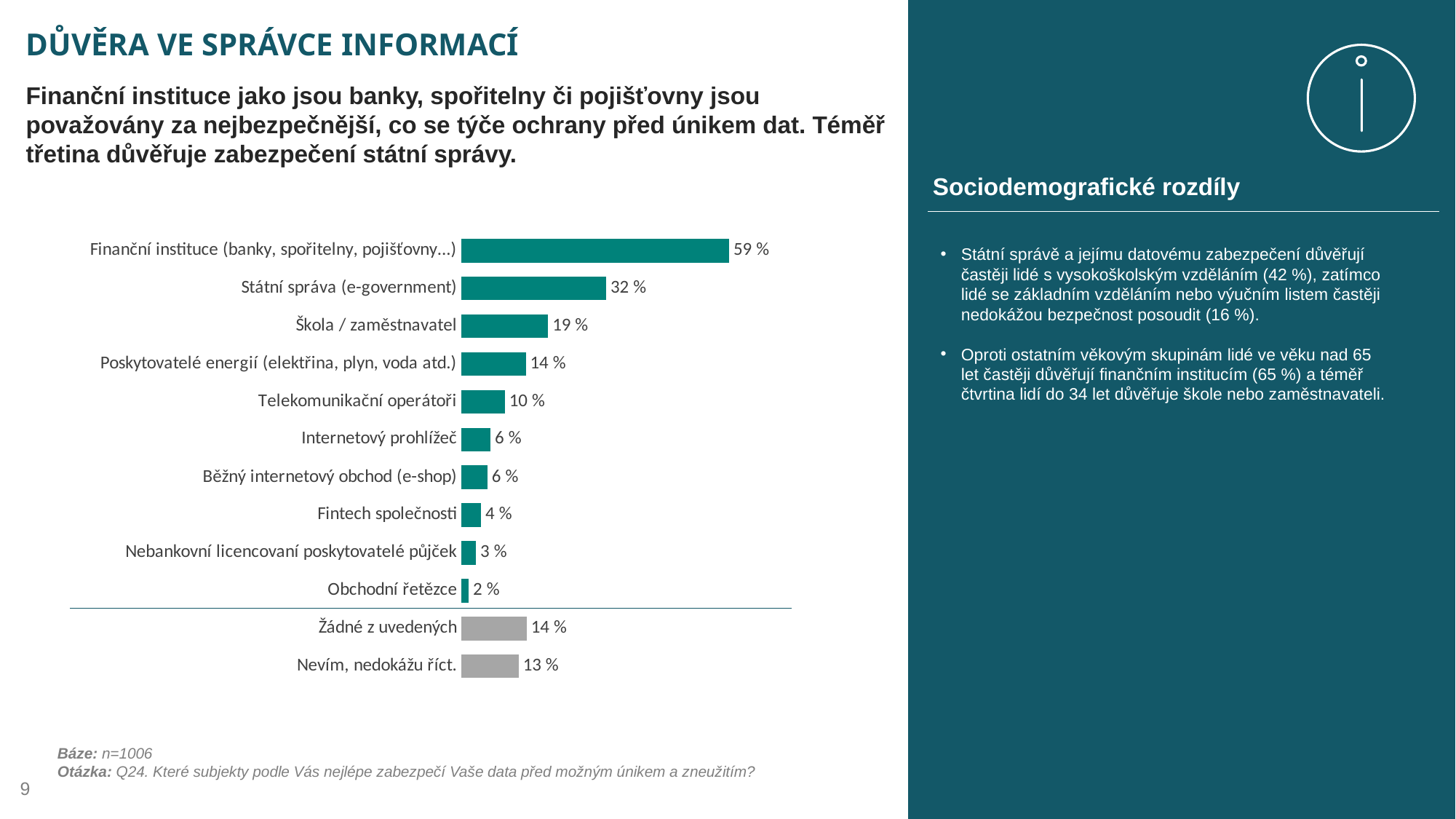
Which is larger, Fintech společnosti or Nebankovní licencovaní poskytovatelé půjček? Fintech společnosti What is the value for Finanční instituce (banky, spořitelny, pojišťovny…)? 59 % What is the difference between Škola / zaměstnavatel and Poskytovatelé energií? 5 % What is the value for Nevím, nedokážu říct.? 13 % What is the value for Telekomunikační operátoři? 10 % What is the difference between Finanční instituce and Státní správa (e-government)? 27 % Which category has the lowest value? Obchodní řetězce Which two categories are shown with grey bars instead of teal? Žádné z uvedených and Nevím, nedokážu říct. What kind of chart is shown on the slide? Bar chart Which category has the highest value? Finanční instituce (banky, spořitelny, pojišťovny…) What is the value for Státní správa (e-government)? 32 % How many categories are shown in the chart? 12